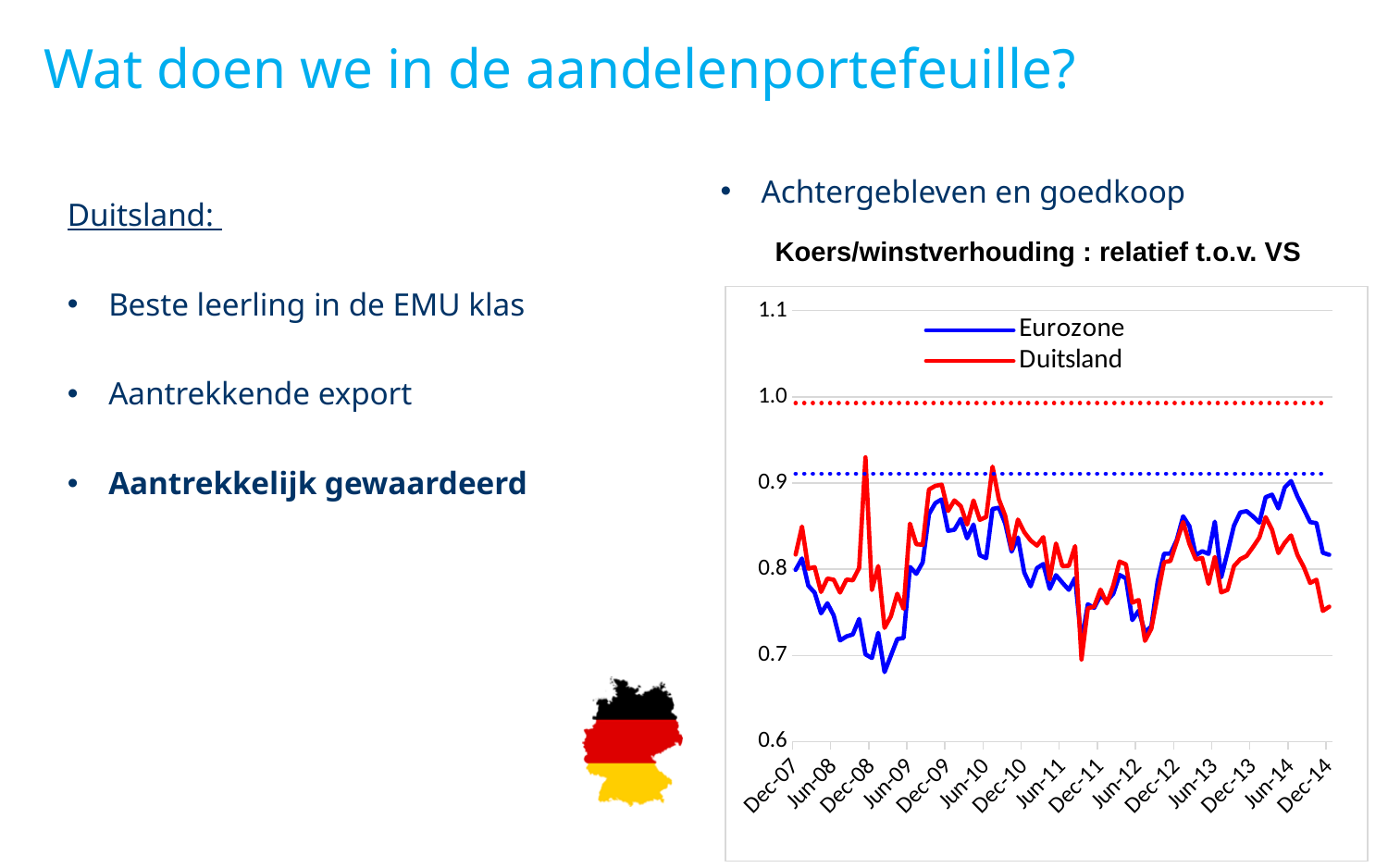
Is the peak of the Duitsland line around Dec-08 greater or less than 0.9? greater What is the title of the chart on the slide? Koers/winstverhouding : relatief t.o.v. VS Does the Eurozone line rise or fall between Jun-09 and Dec-09? rise What kind of chart is shown under the title 'Koers/winstverhouding : relatief t.o.v. VS'? line chart Does the Duitsland line rise or fall between Jun-14 and Dec-14? fall How many date labels are shown on the x axis of the chart? 15 Which colour is used for the Duitsland line in the chart? red How many series does the legend of the chart list? 2 What is the highest value shown on the y axis of the chart? 1.1 Is the lowest value of the Eurozone line (around Jun-09) greater or less than 0.7? less At Dec-14, which series has the higher value, Eurozone or Duitsland? Eurozone Is the value for Duitsland at Dec-14 greater or less than 0.8? less